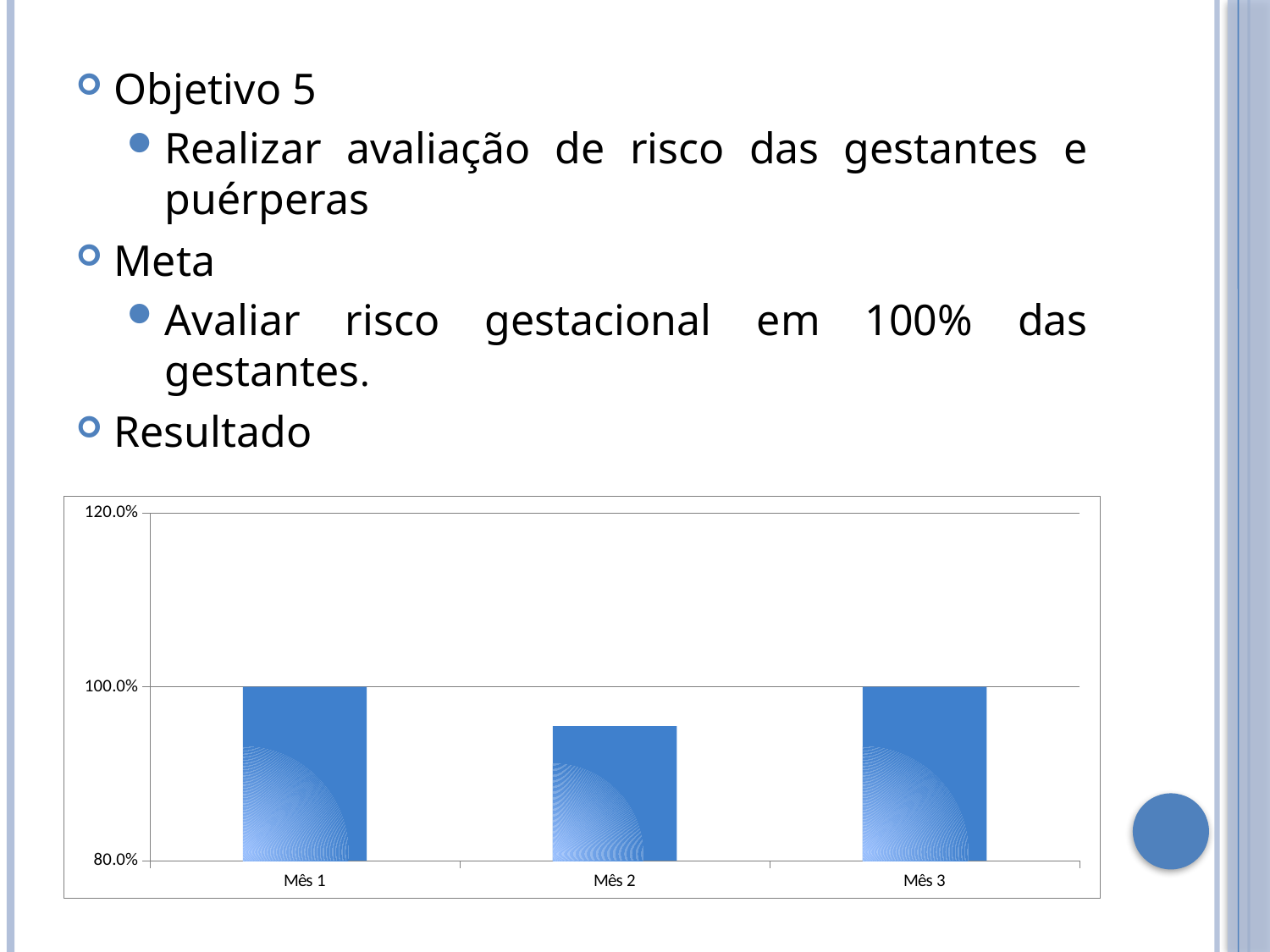
Is the value for Mês 2 greater or less than 80.0%? greater Which category has the lowest value in the chart? Mês 2 Which is larger, the value for Mês 2 or the value for Mês 3? Mês 3 Which is larger, the value for Mês 1 or the value for Mês 2? Mês 1 How many categories are shown on the x axis of the chart? 3 What is the value for Mês 1 in the chart? 100.0% What is the highest tick label shown on the y axis of the chart? 120.0% Is the value for Mês 2 greater or less than 100.0%? less What kind of chart is shown on the slide? bar chart What is the value for Mês 3 in the chart? 100.0% Does the value fall or rise from Mês 2 to Mês 3? rise Does the value fall or rise from Mês 1 to Mês 2? fall